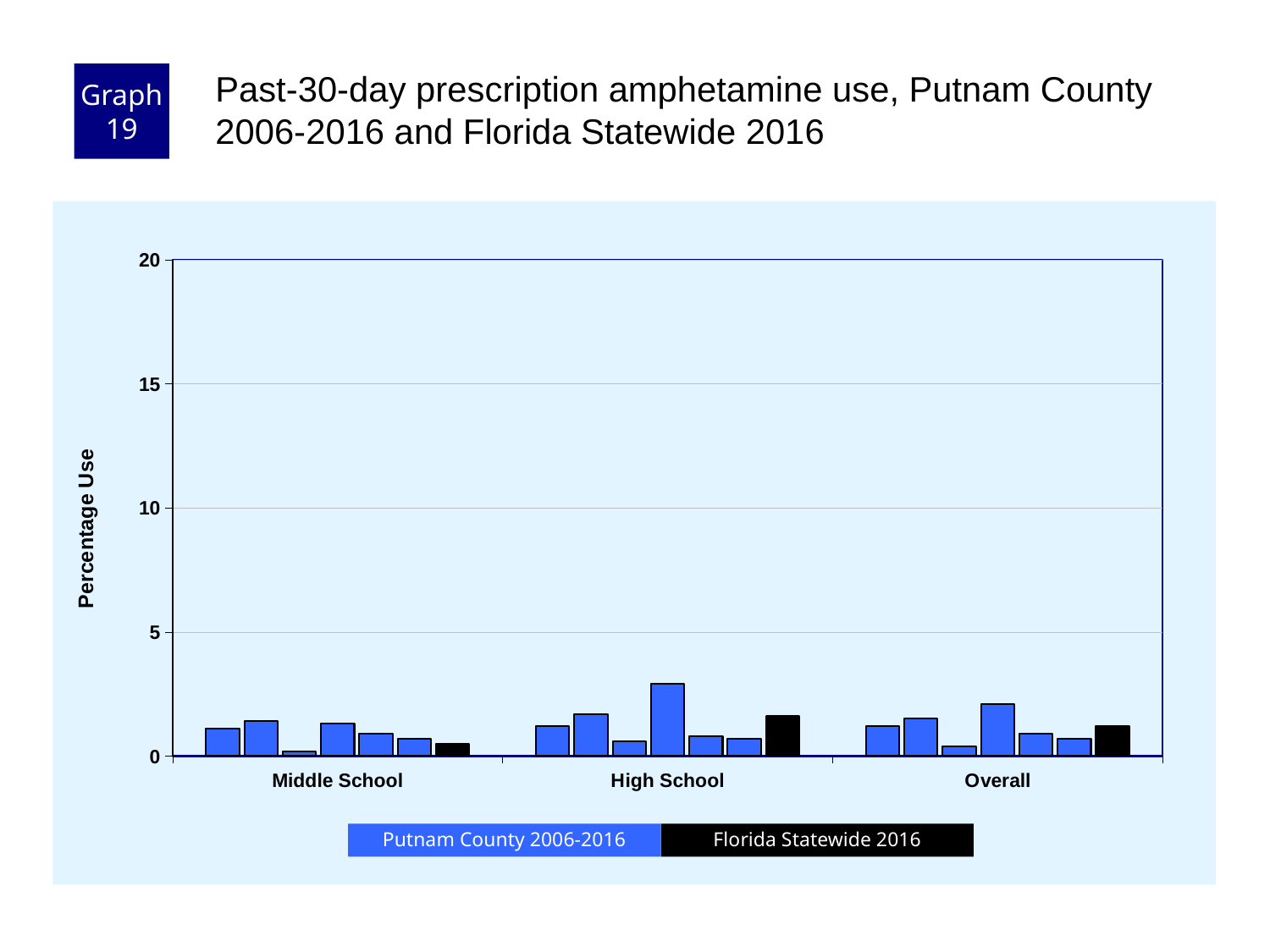
Which is larger, the Florida Statewide 2016 bar for High School or the Florida Statewide 2016 bar for Middle School? High School Which series is shown in black in the legend? Florida Statewide 2016 How many school-level categories are shown along the x axis? 3 Is the tallest bar in the High School group greater or less than 5? less Which category has the lowest Florida Statewide 2016 bar? Middle School What kind of chart is shown on the slide? bar chart Is the Florida Statewide 2016 value for High School greater or less than 5? less Which is larger, the Florida Statewide 2016 bar for Overall or the Florida Statewide 2016 bar for Middle School? Overall Which category group contains the tallest bar on the chart? High School How many series does the legend list? 2 What is the label on the y axis? Percentage Use Is the Florida Statewide 2016 value for Overall greater or less than 5? less